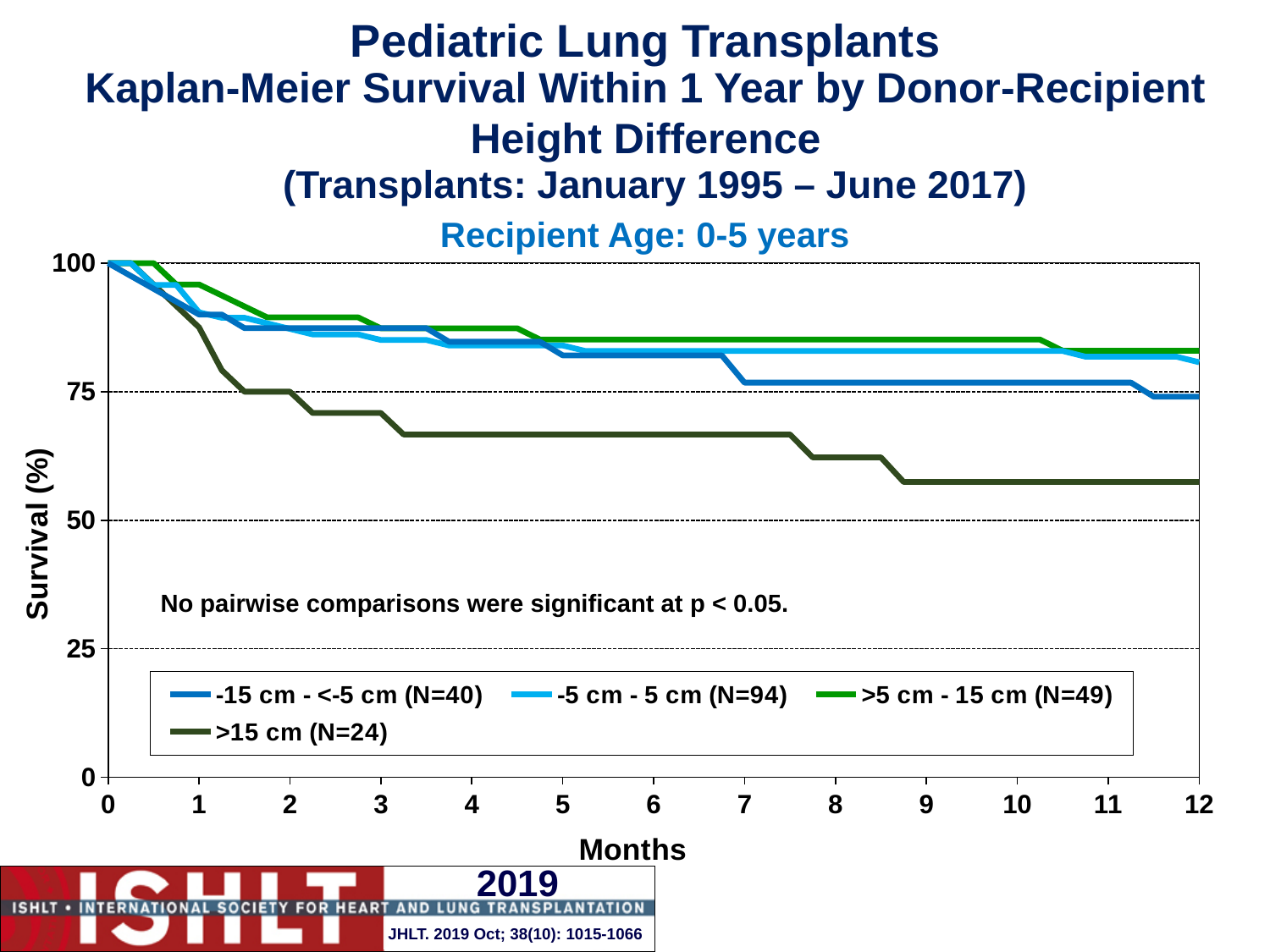
Which donor-recipient height difference group has the lowest survival at 12 months? >15 cm (N=24) Is the survival for the >15 cm group at 3 months greater or less than 75? less Do the survival curves rise or fall as months increase? fall How many series does the legend list? 4 At 12 months, which has higher survival: the >5 cm - 15 cm group or the >15 cm group? >5 cm - 15 cm Is the survival for the >15 cm group at 12 months greater or less than 50? greater What kind of chart is shown on the slide? line chart Is the survival for the >15 cm group at 12 months greater or less than 75? less What is the label of the y axis? Survival (%) How many patients (N) are in the -5 cm - 5 cm group according to the legend? 94